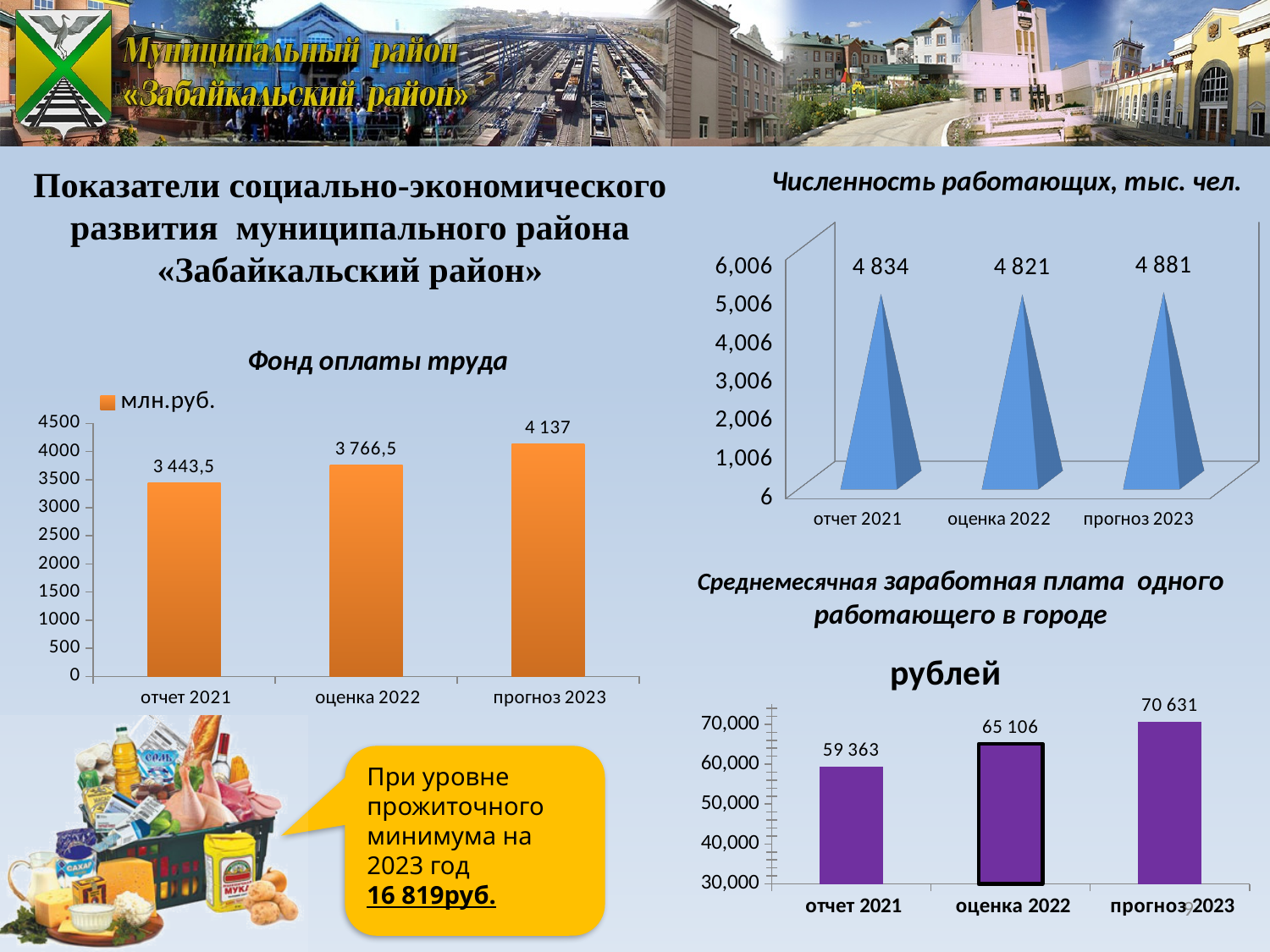
How many categories are shown in the 'Численность работающих, тыс. чел.' chart? 3 What series name does the legend of the 'Фонд оплаты труда' chart show? млн.руб. What kind of chart is the 'Среднемесячная заработная плата одного работающего в городе' chart? bar chart In the 'Численность работающих, тыс. чел.' chart, what is the difference between 'прогноз 2023' and 'оценка 2022'? 60 In the 'Фонд оплаты труда' chart, do the values rise or fall from 'отчет 2021' to 'прогноз 2023'? rise In the 'Среднемесячная заработная плата одного работающего в городе' chart, what is the value for 'отчет 2021'? 59 363 In the 'Фонд оплаты труда' chart, what is the value for 'оценка 2022'? 3 766,5 In the 'Фонд оплаты труда' chart, which category has the highest value? прогноз 2023 In the 'Фонд оплаты труда' chart, what is the difference between 'прогноз 2023' and 'оценка 2022'? 370,5 In the 'Среднемесячная заработная плата одного работающего в городе' chart, what is the difference between 'прогноз 2023' and 'отчет 2021'? 11 268 In the 'Численность работающих, тыс. чел.' chart, what is the value for 'прогноз 2023'? 4 881 In the 'Численность работающих, тыс. чел.' chart, what is the value for 'оценка 2022'? 4 821